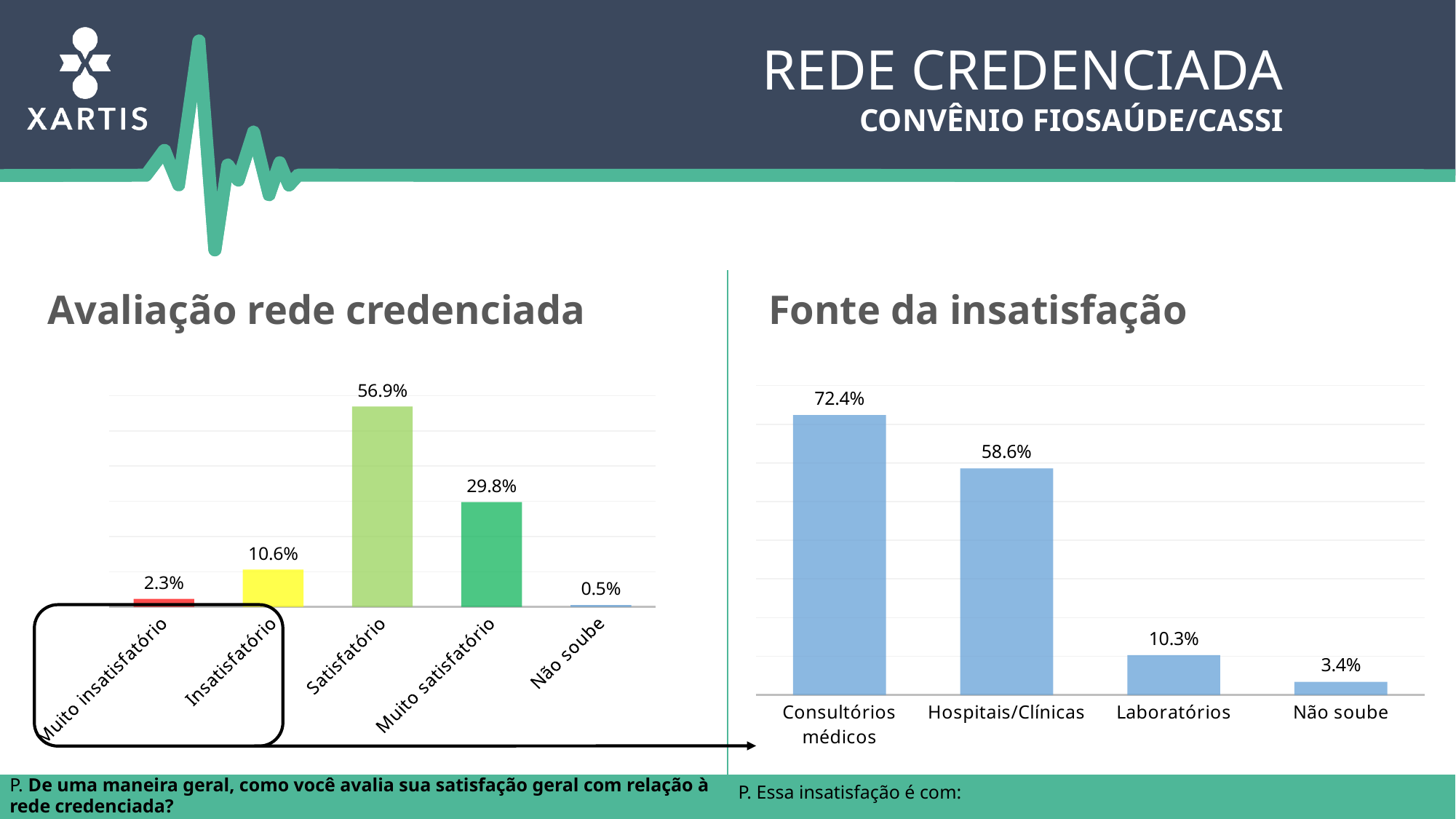
In the 'Fonte da insatisfação' chart, what is the value for Laboratórios? 10.3% In the 'Fonte da insatisfação' chart, what is the difference between Consultórios médicos and Hospitais/Clínicas? 13.8% In the 'Fonte da insatisfação' chart, what is the value for Hospitais/Clínicas? 58.6% What kind of chart is the 'Fonte da insatisfação' chart? Bar chart In the 'Avaliação rede credenciada' chart, what is the value for Muito insatisfatório? 2.3% In the 'Avaliação rede credenciada' chart, which category has the highest value? Satisfatório In the 'Fonte da insatisfação' chart, which is larger: Laboratórios or Não soube? Laboratórios In the 'Avaliação rede credenciada' chart, what is the difference between Satisfatório and Muito satisfatório? 27.1% In the 'Avaliação rede credenciada' chart, what is the value for Satisfatório? 56.9% In the 'Fonte da insatisfação' chart, which category has the highest value? Consultórios médicos In the 'Avaliação rede credenciada' chart, which category has the lowest value? Não soube In the 'Avaliação rede credenciada' chart, how many categories are shown? 5